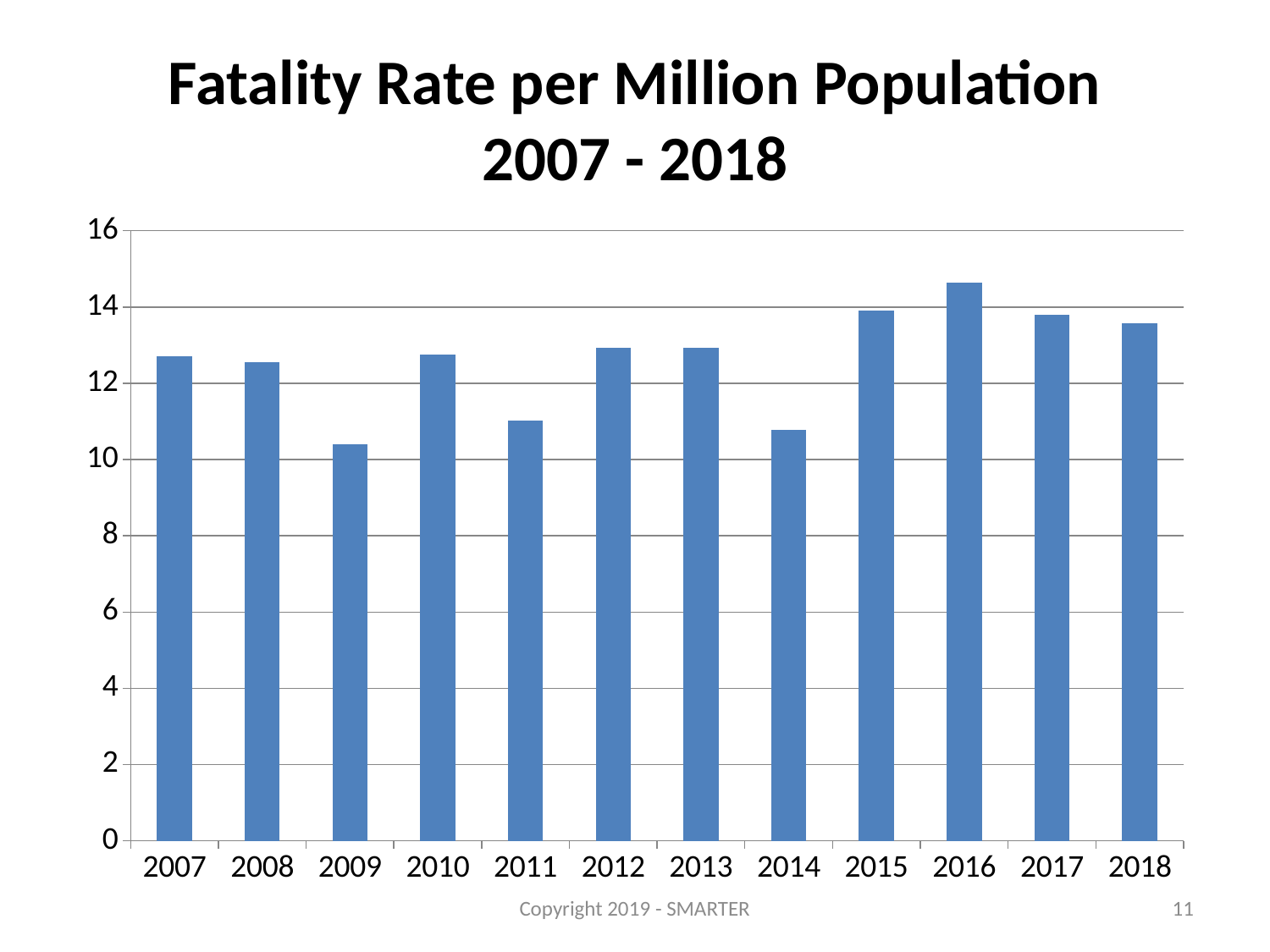
What kind of chart is shown on the slide? bar chart What is the highest value shown on the vertical axis? 16 Which is larger, the value for 2009 or the value for 2007? 2007 Which is larger, the value for 2015 or the value for 2011? 2015 Is the value for 2018 greater or less than 14? less Is the value for 2009 greater or less than 12? less What is the title of the chart? Fatality Rate per Million Population 2007 - 2018 Is the value for 2016 greater or less than 14? greater Which year has the highest fatality rate per million population? 2016 How many years (bars) are plotted in the chart? 12